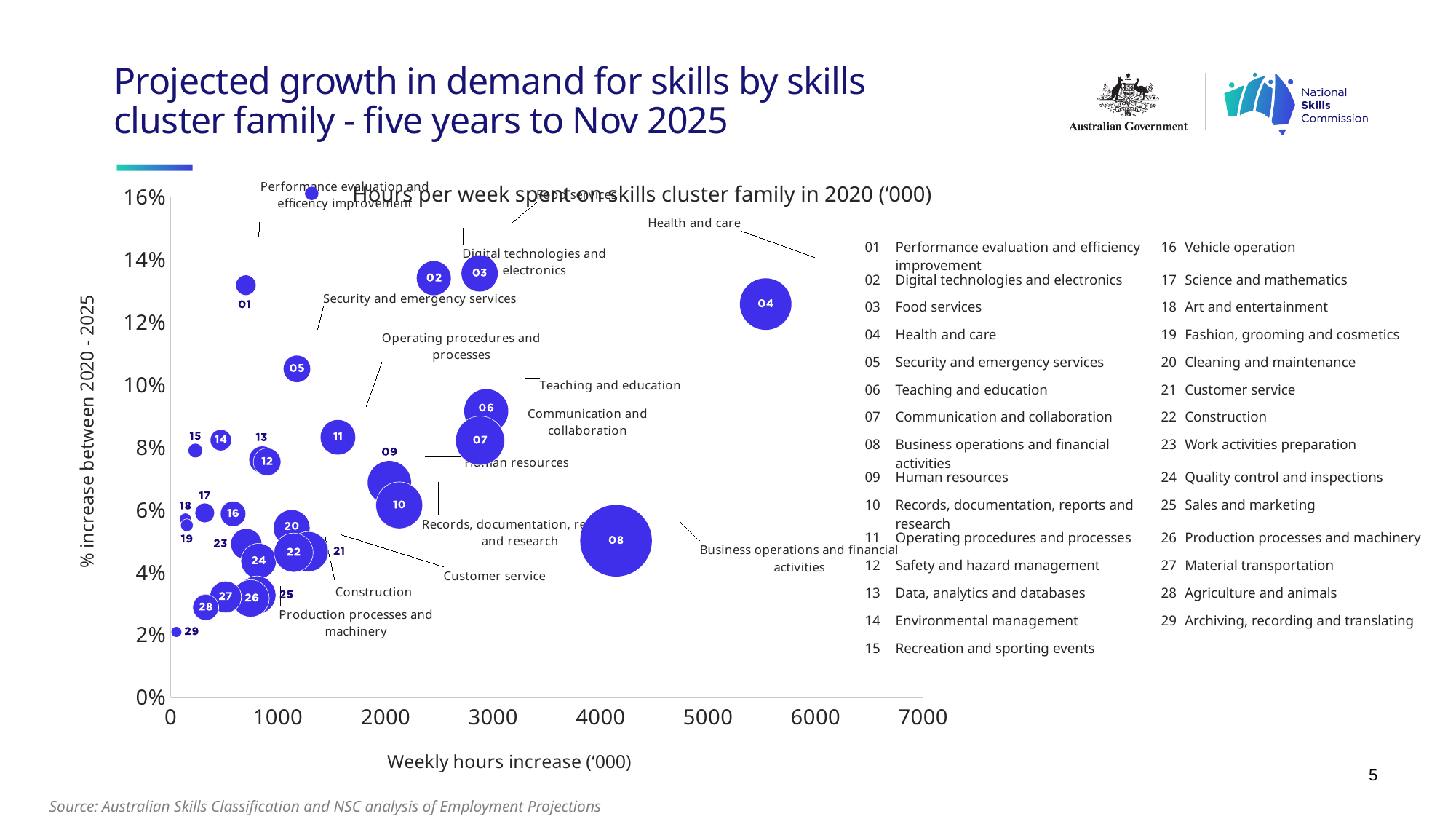
What is the label of the x axis? Weekly hours increase ('000) Which skills cluster family has the largest weekly hours increase on the chart? Health and care What does the size of the bubbles represent? Hours per week spent on skills cluster family in 2020 ('000) Which skills cluster family has the lowest % increase between 2020 and 2025? Archiving, recording and translating Is the % increase for Security and emergency services greater or less than 10%? greater Which has a higher % increase between 2020 and 2025: Health and care or Teaching and education? Health and care Is the weekly hours increase for Health and care greater or less than 5000? greater How many skills cluster families are plotted on the chart? 29 What kind of chart is shown on the slide? bubble chart Is the % increase for Health and care greater or less than 12%? greater Which skills cluster family is shown with the largest bubble? Business operations and financial activities